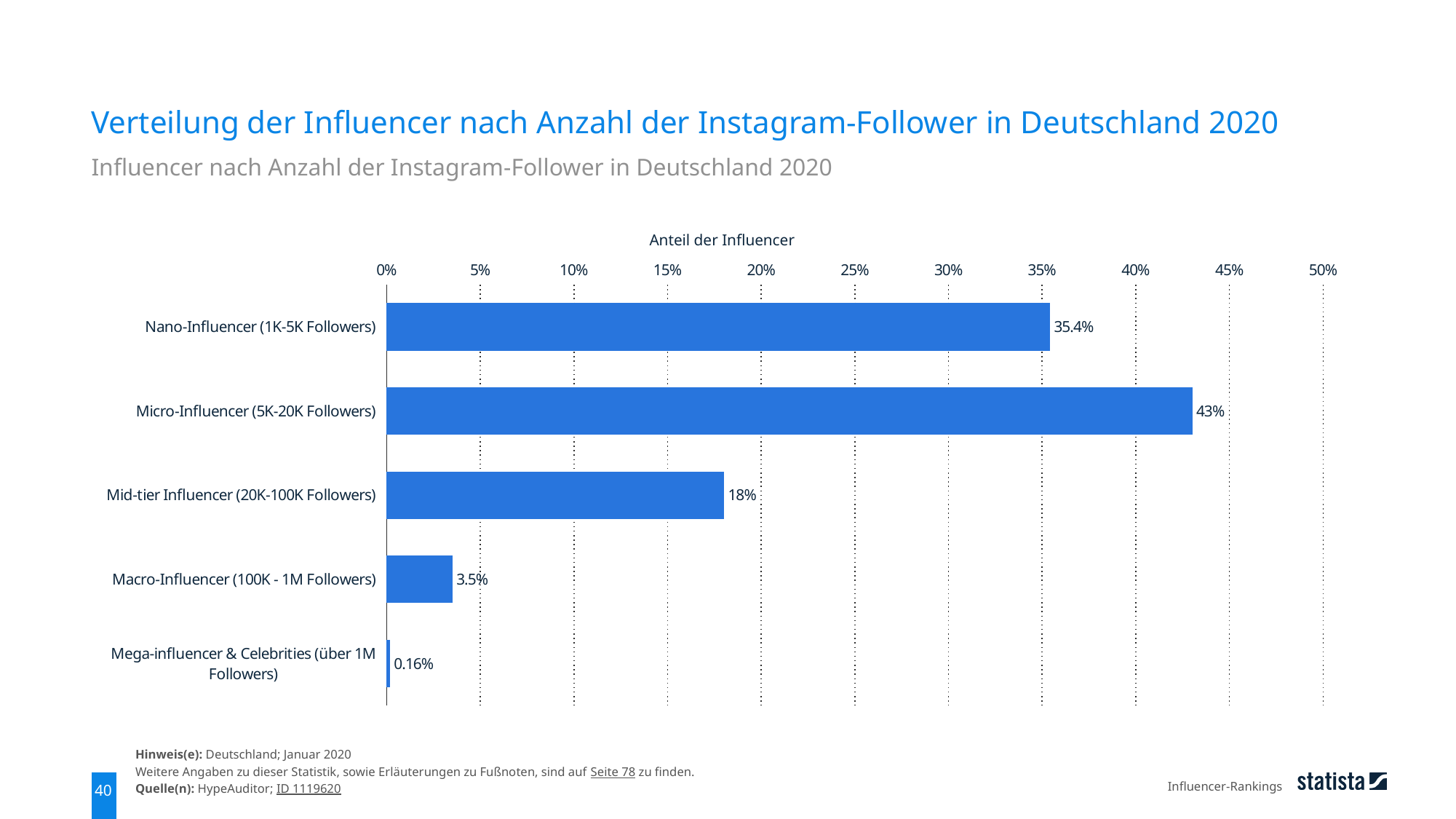
What kind of chart is shown on the slide? Bar chart What is the label of the value axis? Anteil der Influencer Which is larger, the value for Mid-tier Influencer (20K-100K Followers) or Macro-Influencer (100K - 1M Followers)? Mid-tier Influencer (20K-100K Followers) Which category has the highest share of influencers? Micro-Influencer (5K-20K Followers) What is the difference between the values for Mid-tier Influencer (20K-100K Followers) and Macro-Influencer (100K - 1M Followers)? 14.5% What is the difference between the values for Micro-Influencer (5K-20K Followers) and Nano-Influencer (1K-5K Followers)? 7.6% What is the value for Nano-Influencer (1K-5K Followers)? 35.4% Is the value for Nano-Influencer (1K-5K Followers) greater or less than 30%? greater What is the value for Mega-influencer & Celebrities (über 1M Followers)? 0.16% What is the value for Micro-Influencer (5K-20K Followers)? 43% Which category has the lowest share of influencers? Mega-influencer & Celebrities (über 1M Followers) How many categories are shown in the chart? 5